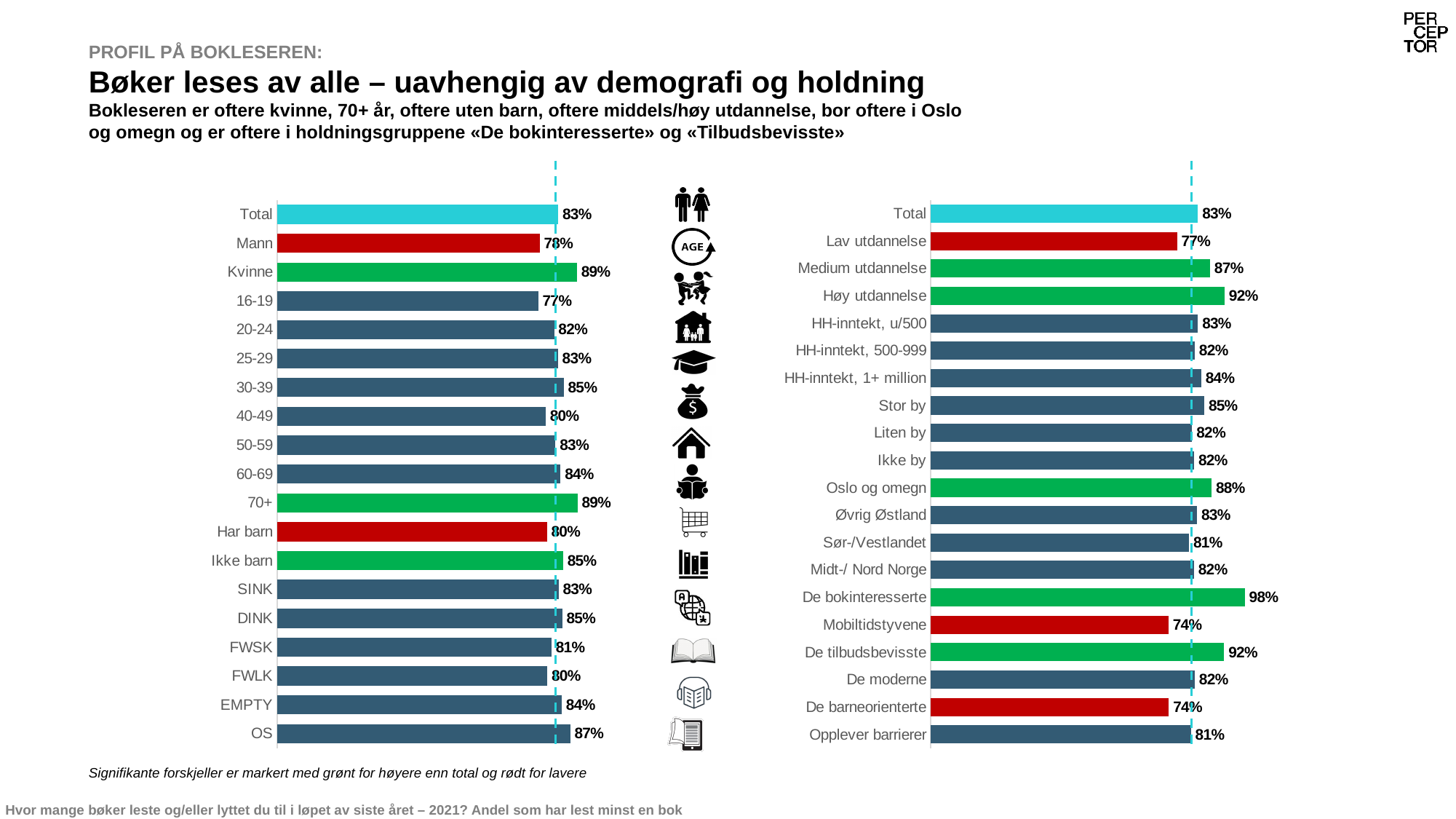
On the left chart, which is larger, the value for OS or the value for FWLK? OS On the right chart, what is the value for Høy utdannelse? 92% What kind of chart is the left chart? bar chart On the left chart, what is the value for Kvinne? 89% On the right chart, what is the value for Oslo og omegn? 88% On the right chart, which category has the highest value? De bokinteresserte On the left chart, what is the difference between the values for Kvinne and Mann? 11% On the left chart, which category has the lowest value? 16-19 On the right chart, what is the difference between the values for De bokinteresserte and Mobiltidstyvene? 24% How many categories does the right chart show? 20 On the left chart, what is the value for Har barn? 80% On the right chart, which is larger, the value for Lav utdannelse or the value for Medium utdannelse? Medium utdannelse